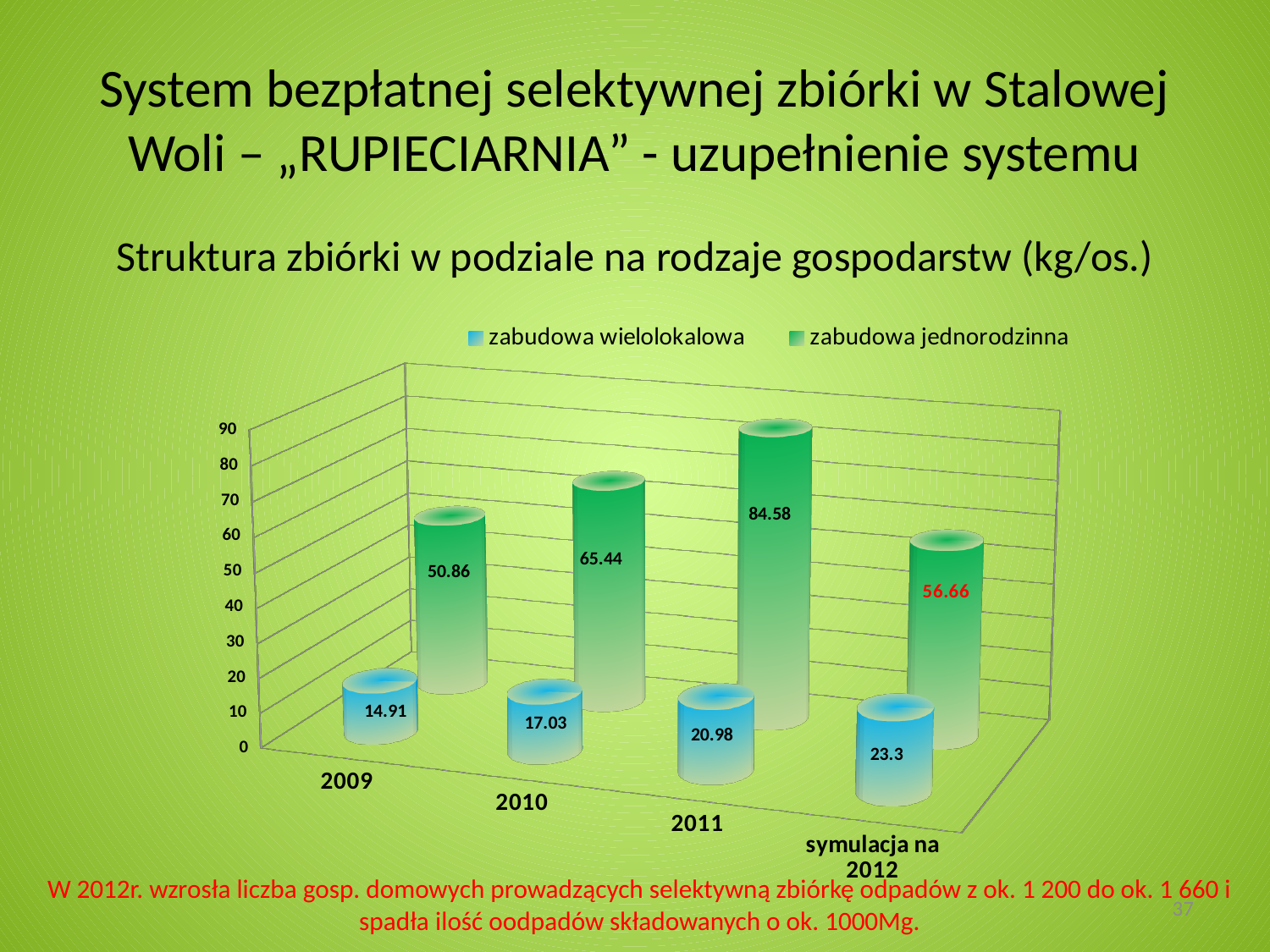
What is the difference between zabudowa jednorodzinna and zabudowa wielolokalowa in 2011? 63.6 What is the value for zabudowa jednorodzinna in 2010? 65.44 Do the values for zabudowa wielolokalowa rise or fall from 2009 to the 'symulacja na 2012' category? rise In which year is the value for zabudowa jednorodzinna highest? 2011 What is the value for zabudowa jednorodzinna in 2011? 84.58 How many series does the chart legend list? 2 In which category is the value for zabudowa wielolokalowa lowest? 2009 What is the value for zabudowa wielolokalowa in 2009? 14.91 How many categories are shown on the x axis of the chart? 4 Which is larger: zabudowa jednorodzinna in 2010 or zabudowa jednorodzinna in the 'symulacja na 2012' category? zabudowa jednorodzinna in 2010 What is the value for zabudowa wielolokalowa in the 'symulacja na 2012' category? 23.3 What kind of chart is shown on the slide? bar chart